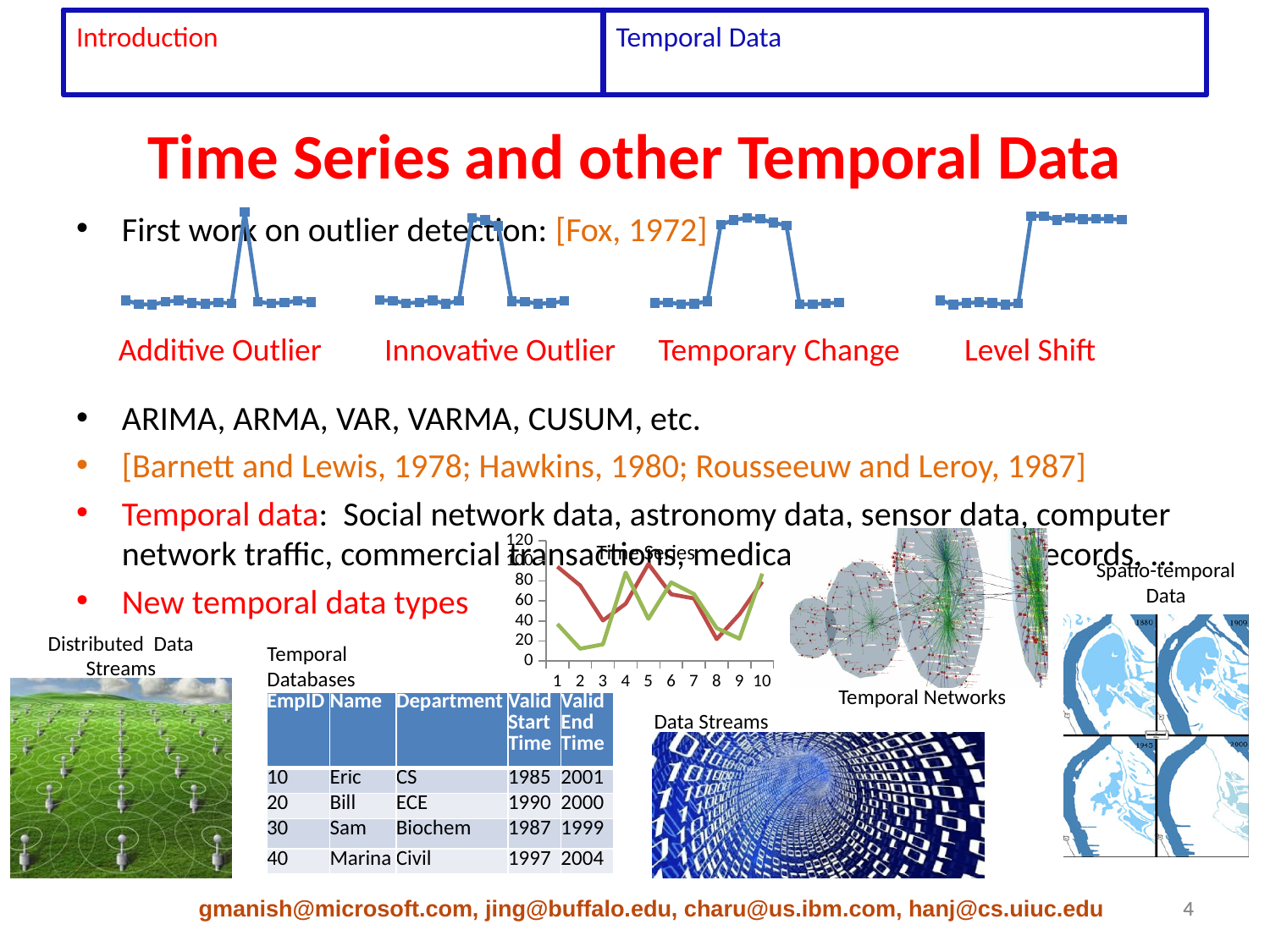
In the 'Time Series' chart, is the value of the red line at x = 9 greater or less than 40? greater In the 'Time Series' chart, is the value of the green line at x = 5 greater or less than 80? less In the 'Time Series' chart, is the value of the red line at x = 1 greater or less than 60? greater In the 'Time Series' chart, which line has the larger value at x = 1, the red line or the green line? red line In the 'Time Series' chart, what is the highest value shown on the y axis? 120 In the 'Time Series' chart, how many points are labelled along the x axis? 10 In the 'Time Series' chart, what colours are the two plotted lines? red and green In the 'Time Series' chart, does the red line rise or fall from x = 1 to x = 3? fall What kind of chart is the small 'Time Series' chart in the middle of the slide? line chart In the 'Time Series' chart, which line has the larger value at x = 10, the red line or the green line? green line In the 'Time Series' chart, how many lines are plotted? 2